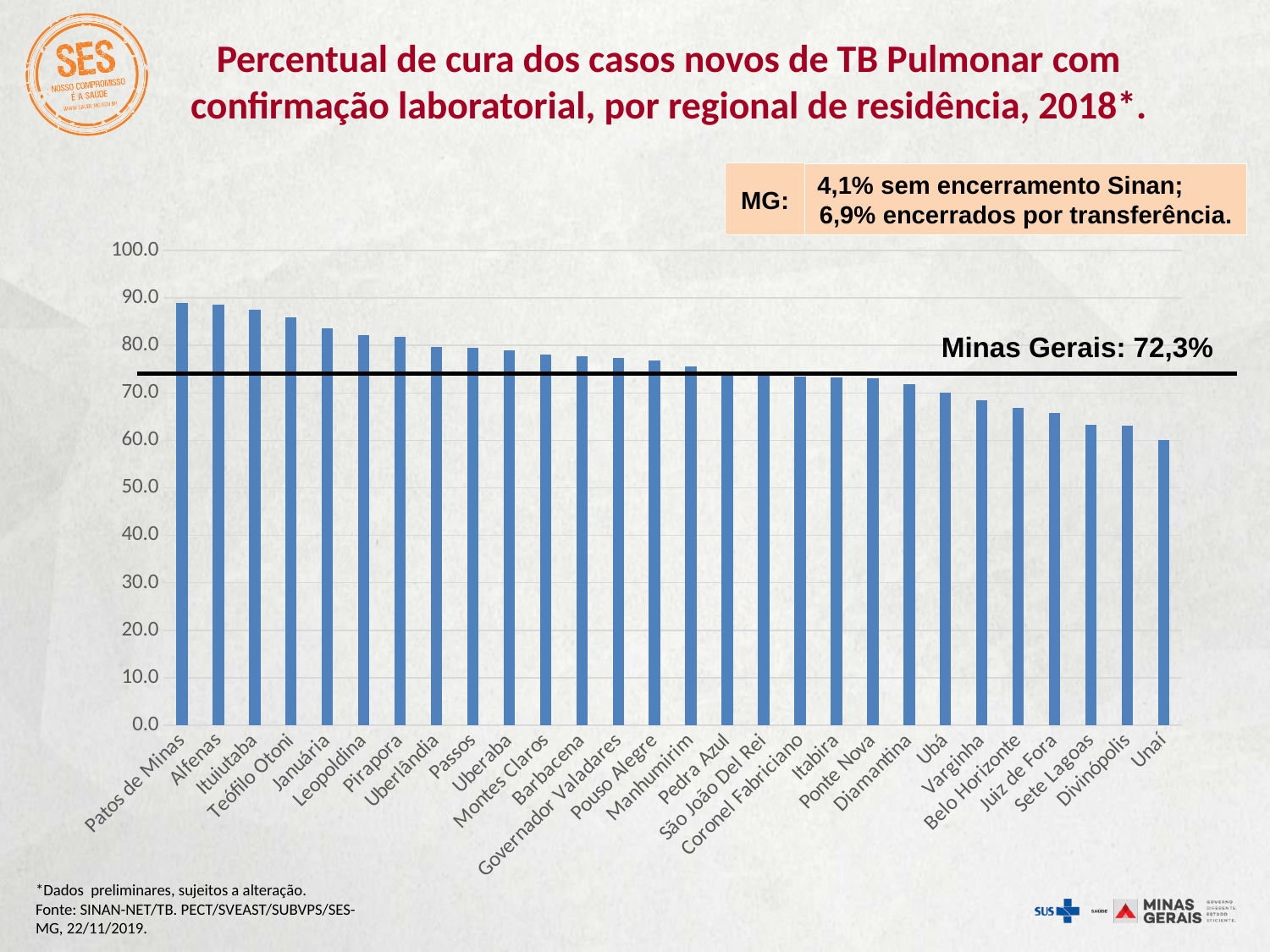
How many regionals (bars) are plotted in the chart? 28 Which regional has the lowest cure percentage in the chart? Unaí Which has a higher value, Alfenas or Unaí? Alfenas What kind of chart is shown on the slide? bar chart Is the value for Patos de Minas greater or less than 80? greater Is the value for Unaí greater or less than 70? less According to the box on the slide, what percentage of MG cases were closed by transfer (encerrados por transferência)? 6,9% Is the value for Ituiutaba greater or less than 80? greater Which has a higher value, Uberlândia or Belo Horizonte? Uberlândia Do the bar values rise or fall from left to right along the x axis? fall What is the Minas Gerais reference value shown on the chart? 72,3%